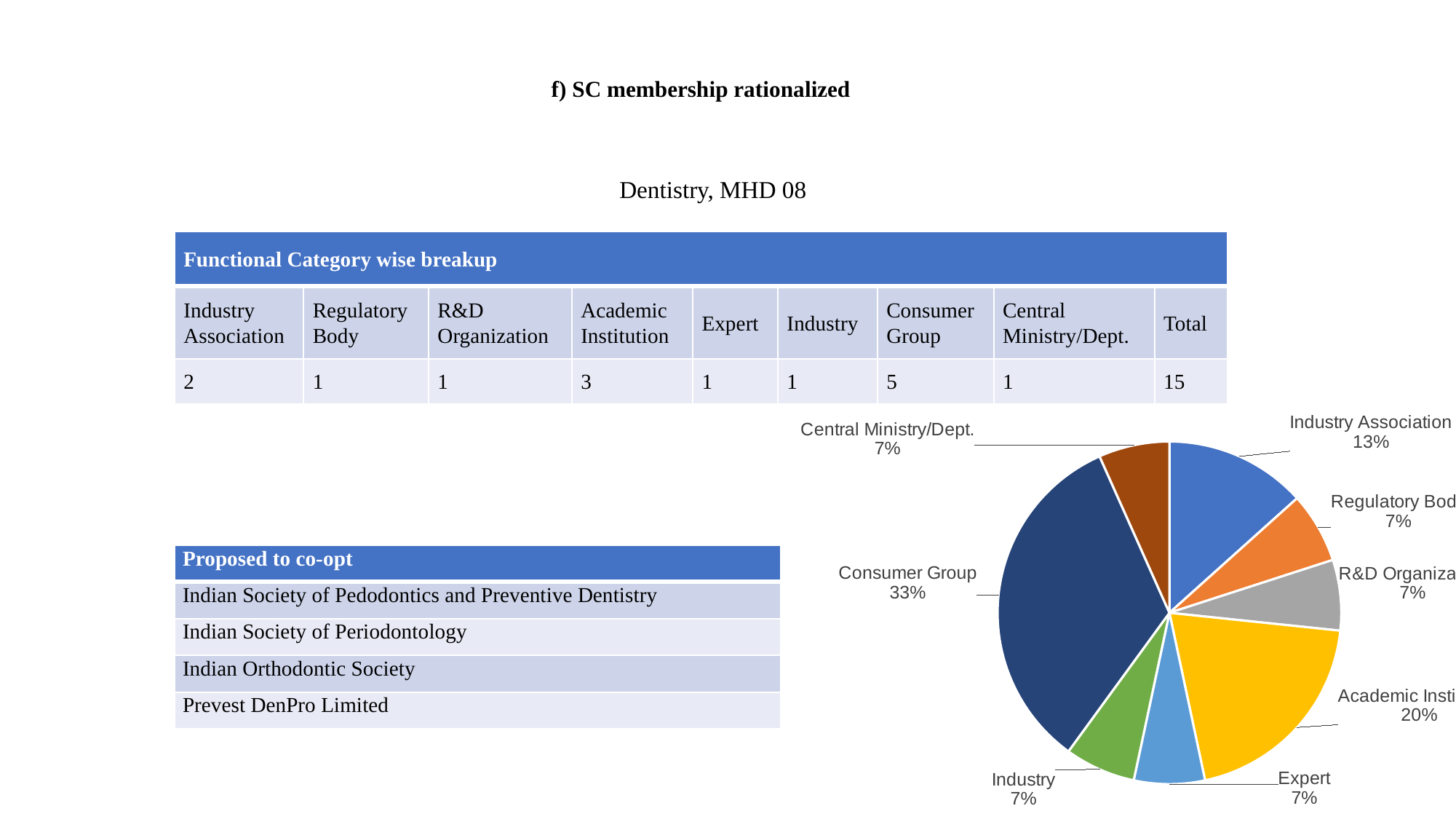
What percentage is shown for Central Ministry/Dept. in the pie chart? 7% How many slices does the pie chart have? 8 What share of the pie does Consumer Group represent? 33% What colour is the Consumer Group slice in the pie chart? Dark blue Which is larger in the pie chart, Academic Institution or Consumer Group? Consumer Group Which category has the largest slice of the pie chart? Consumer Group What share of the pie does Academic Institution represent? 20% What is the difference in percentage points between the Consumer Group slice and the Academic Institution slice? 13 Which is larger in the pie chart, Industry Association or Expert? Industry Association What kind of chart is shown on the slide? Pie chart How many slices in the pie chart are labelled 7%? 5 What share of the pie does Industry Association represent? 13%